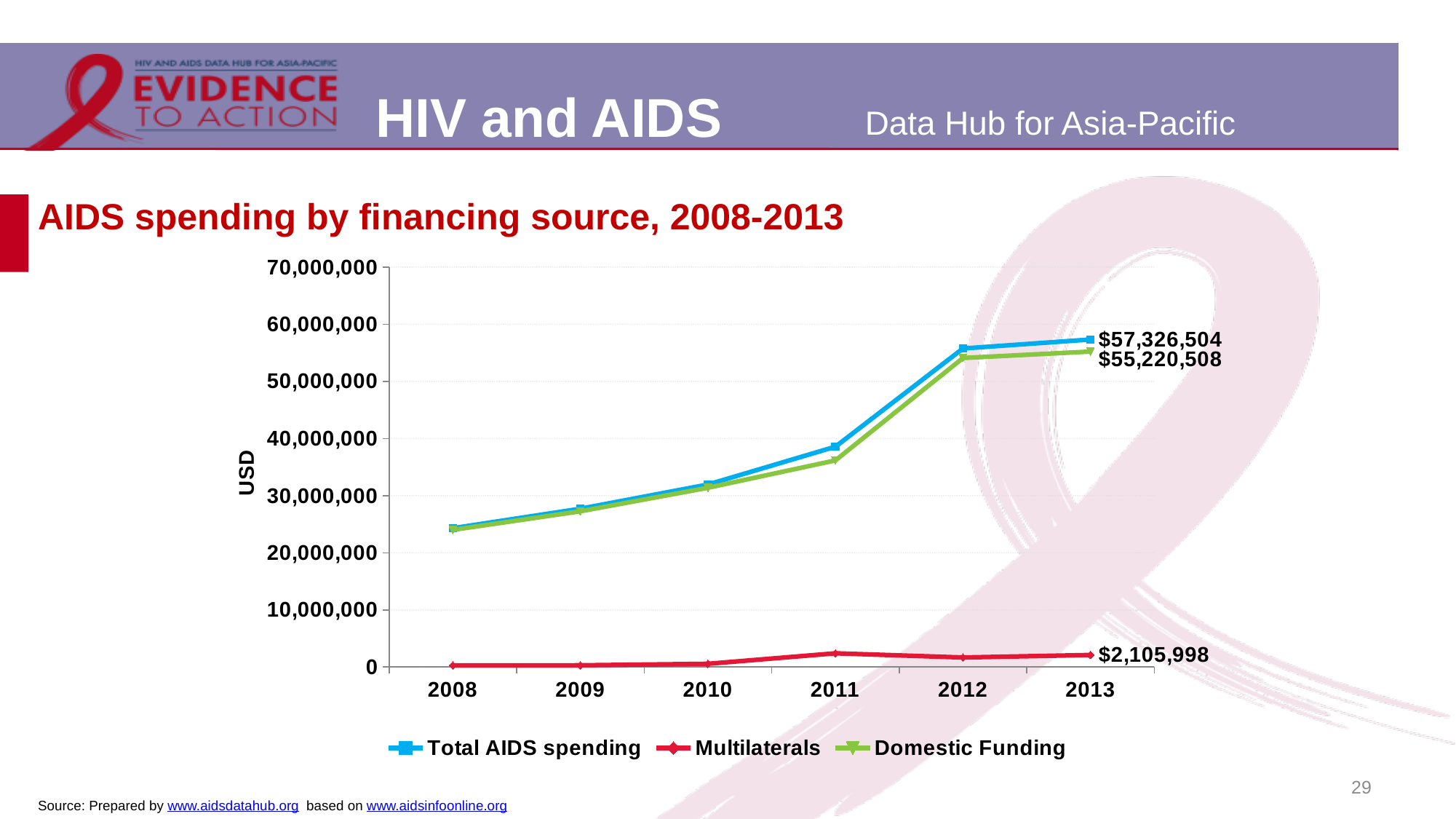
In 2013, which is larger: Domestic Funding or Multilaterals? Domestic Funding Which series has the lowest value in 2013? Multilaterals What is the value of Domestic Funding in 2013? $55,220,508 What is the value of Multilaterals in 2013? $2,105,998 Does Total AIDS spending rise or fall from 2008 to 2013? Rise How many years are shown on the x axis? 6 Is the value for Multilaterals in 2011 greater or less than 10,000,000? less How many series does the legend list? 3 What is the value of Total AIDS spending in 2013? $57,326,504 What is the difference between Total AIDS spending and Domestic Funding in 2013? $2,105,996 What kind of chart is shown on the slide? Line chart Is the value for Total AIDS spending in 2008 greater or less than 30,000,000? less